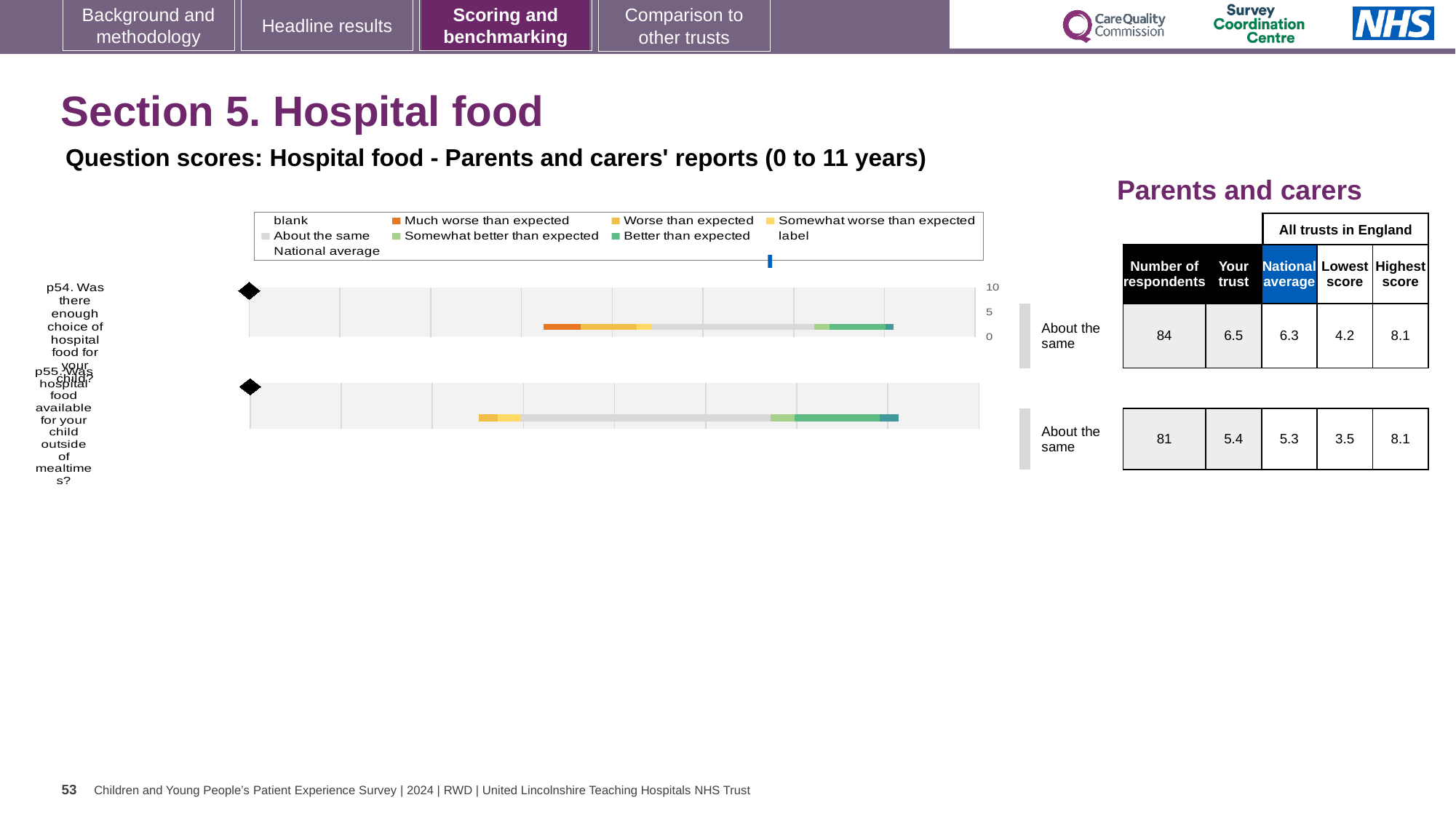
What is the difference between the highest and lowest scores for p55? 4.6 What benchmark category is the trust's result for p55 placed in? About the same What is the highest score among all trusts in England for p55? 8.1 What is the 'Your trust' score for p54 (enough choice of hospital food)? 6.5 How many survey questions (bars) are plotted on the slide? 2 Which question has the higher 'Your trust' score, p54 or p55? p54 What is the lowest score among all trusts in England for p54? 4.2 What is the national average score for p54? 6.3 How many respondents answered p55 (hospital food available outside of mealtimes)? 81 By how much does the trust's score for p54 exceed the national average? 0.2 Which legend entry is shown in orange? Much worse than expected What kind of chart is used to show the question scores for p54 and p55? bar chart